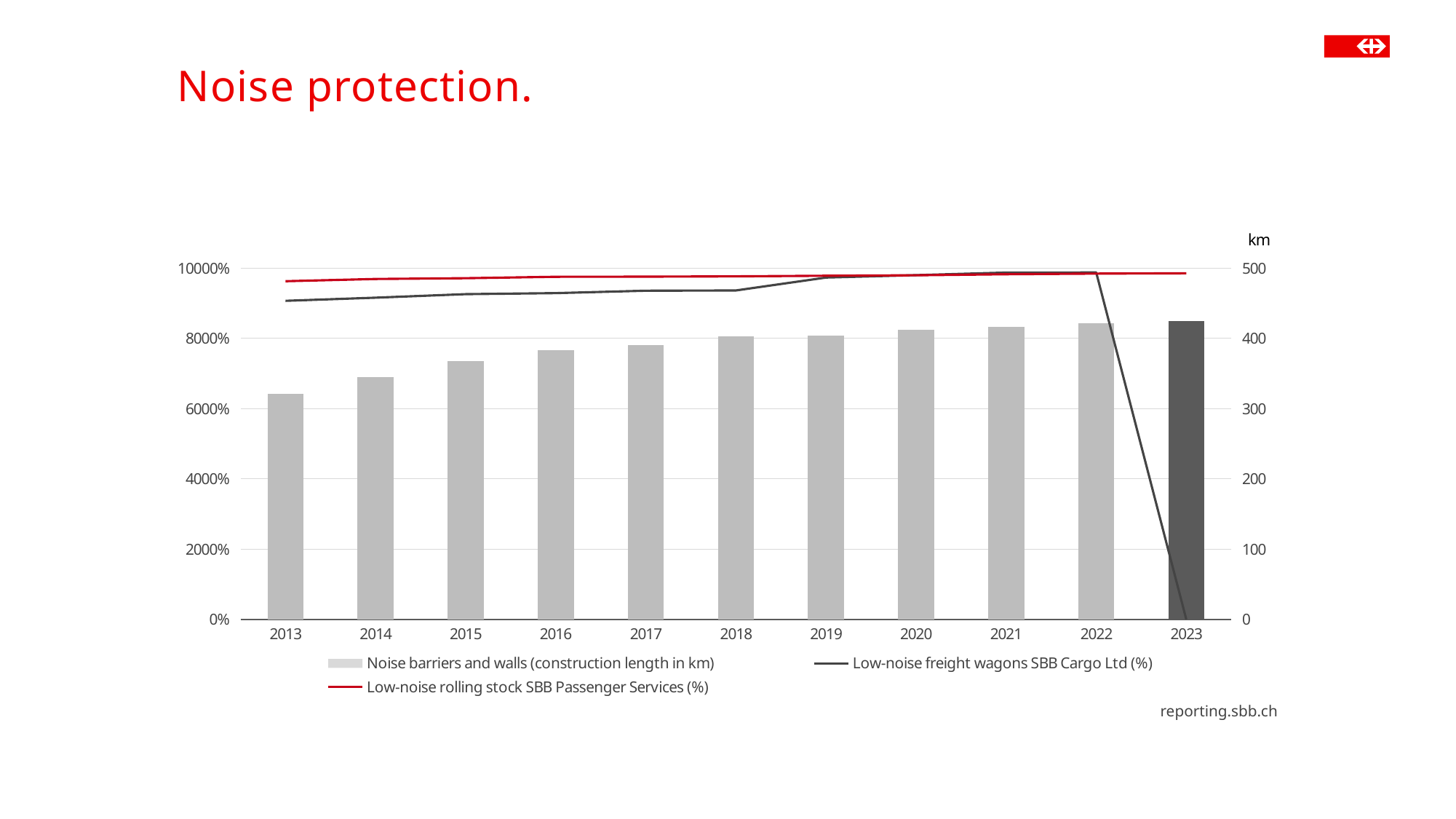
Do the values for Noise barriers and walls rise or fall from 2013 to 2023? rise Is the value for Noise barriers and walls in 2013 greater or less than 300 km? greater What kind of chart is shown on the slide? A combined bar and line chart Is the value for Noise barriers and walls in 2015 greater or less than 400 km? less What unit is shown at the top of the right-hand axis? km Is the value for Noise barriers and walls in 2023 greater or less than 400 km? greater How many series does the legend list? 3 Which year has the highest value for Noise barriers and walls (construction length in km)? 2023 How many years are shown on the x axis? 11 Which year has the lowest value for Noise barriers and walls (construction length in km)? 2013 Which is larger, the Noise barriers and walls value for 2023 or for 2014? 2023 What is the title of the chart on the slide? Noise protection.